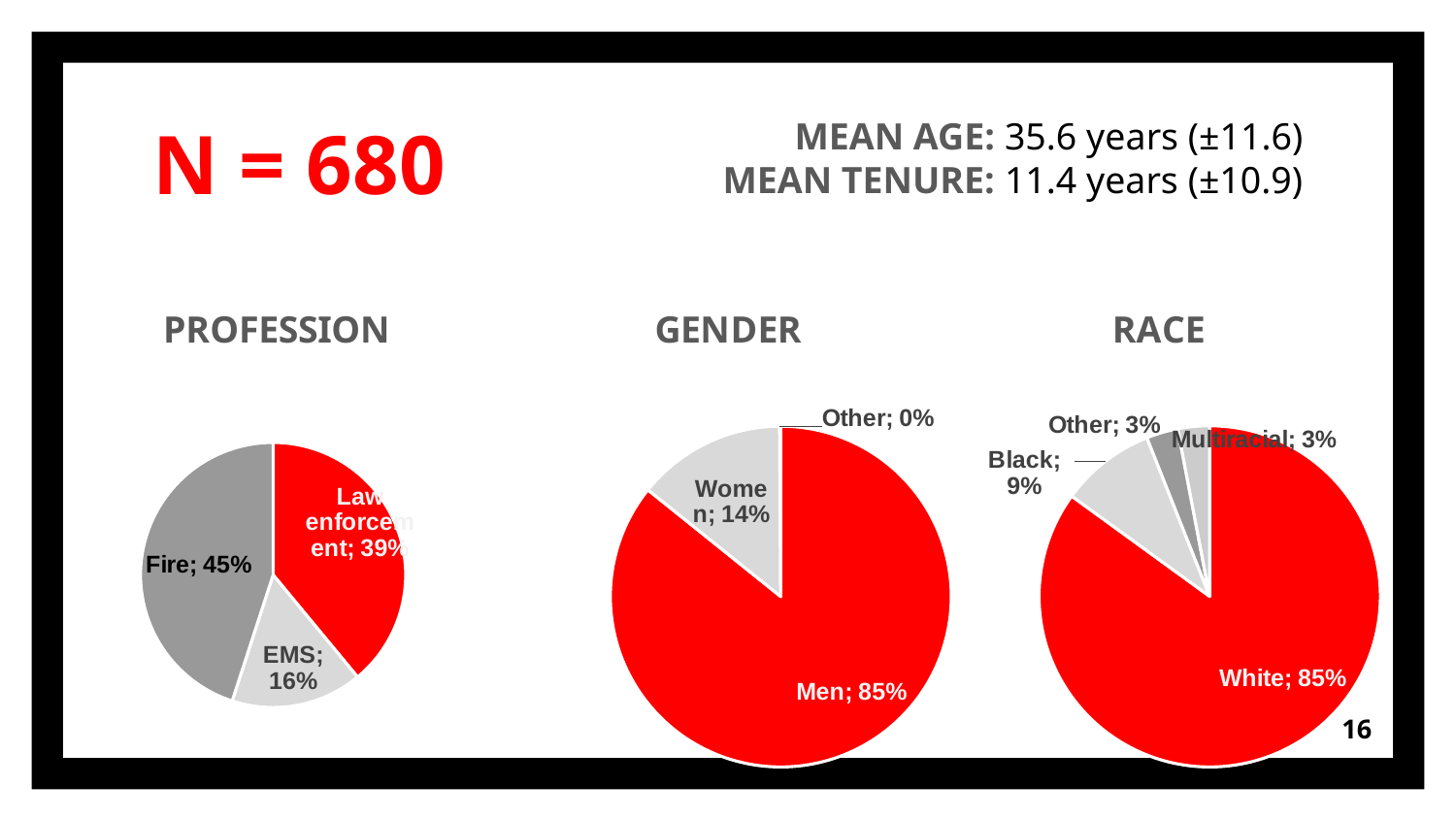
In the PROFESSION chart, which profession has the smallest share? EMS In the PROFESSION chart, what share of respondents are EMS? 16% In the PROFESSION chart, what is the difference in percentage points between Fire and Law enforcement? 6 percentage points What type of chart is used for the PROFESSION, GENDER and RACE data? Pie chart In the RACE chart, what share of respondents are Black? 9% In the PROFESSION chart, which profession has the largest share? Fire In the GENDER chart, what share of respondents are Women? 14% How many slices does the GENDER chart have? 3 In the RACE chart, what share of respondents are Multiracial? 3% How many slices does the RACE chart have? 4 In the GENDER chart, what share of respondents are Men? 85% In the PROFESSION chart, what share of respondents are Fire? 45%